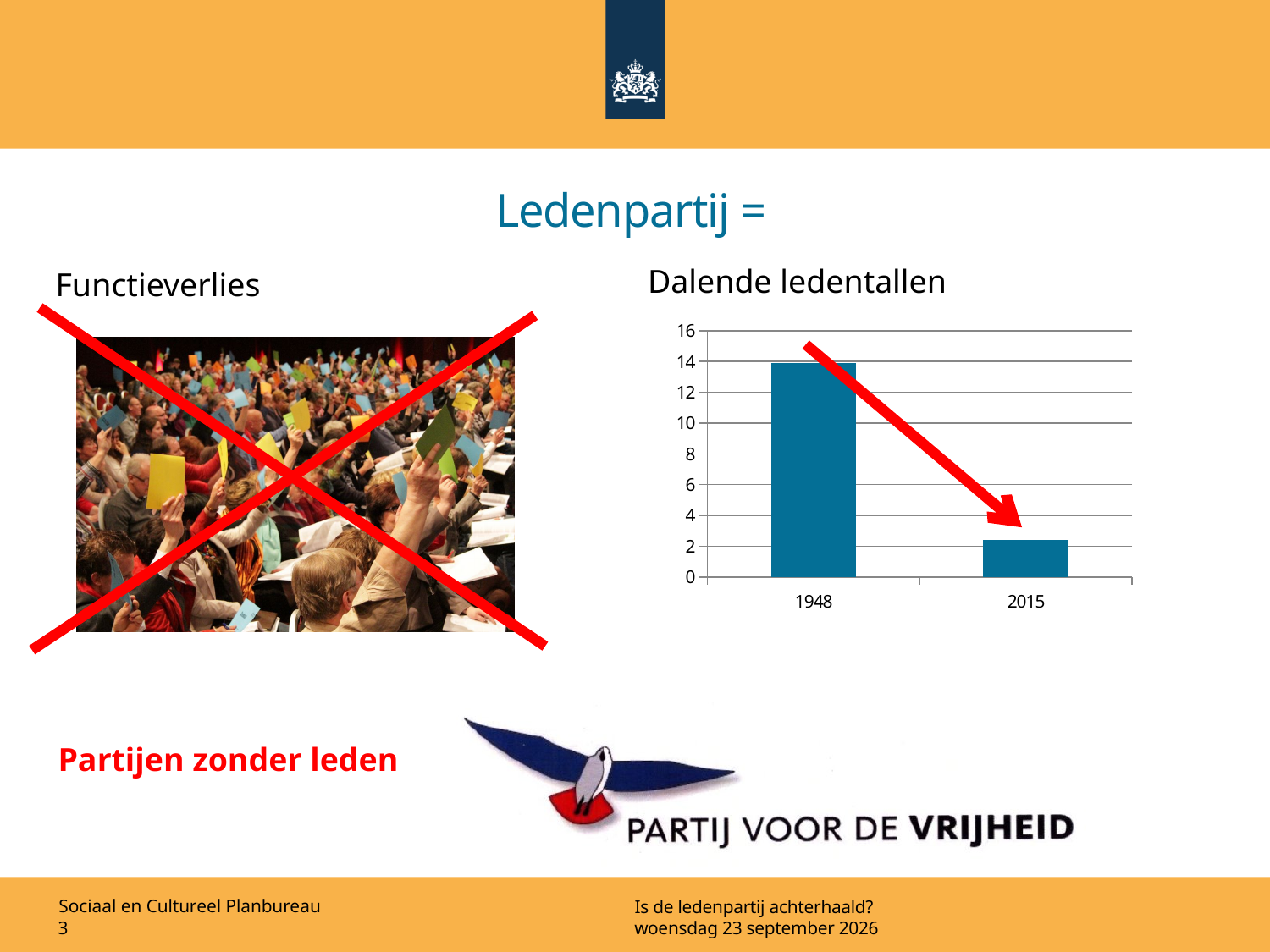
In the 'Dalende ledentallen' chart, is the value for 2015 greater or less than 4? less What is the highest value shown on the y axis of the 'Dalende ledentallen' chart? 16 What is the title above the bar chart on the slide? Dalende ledentallen How many bars does the 'Dalende ledentallen' chart show? 2 In the 'Dalende ledentallen' chart, is the value for 1948 greater or less than 10? greater Do the values in the 'Dalende ledentallen' chart rise or fall from 1948 to 2015? fall What kind of chart is shown under 'Dalende ledentallen'? bar chart In the 'Dalende ledentallen' chart, is the value for 1948 greater or less than 16? less Which year has the lowest value in the 'Dalende ledentallen' chart? 2015 In the 'Dalende ledentallen' chart, which is larger: the value for 1948 or the value for 2015? 1948 Which year has the highest value in the 'Dalende ledentallen' chart? 1948